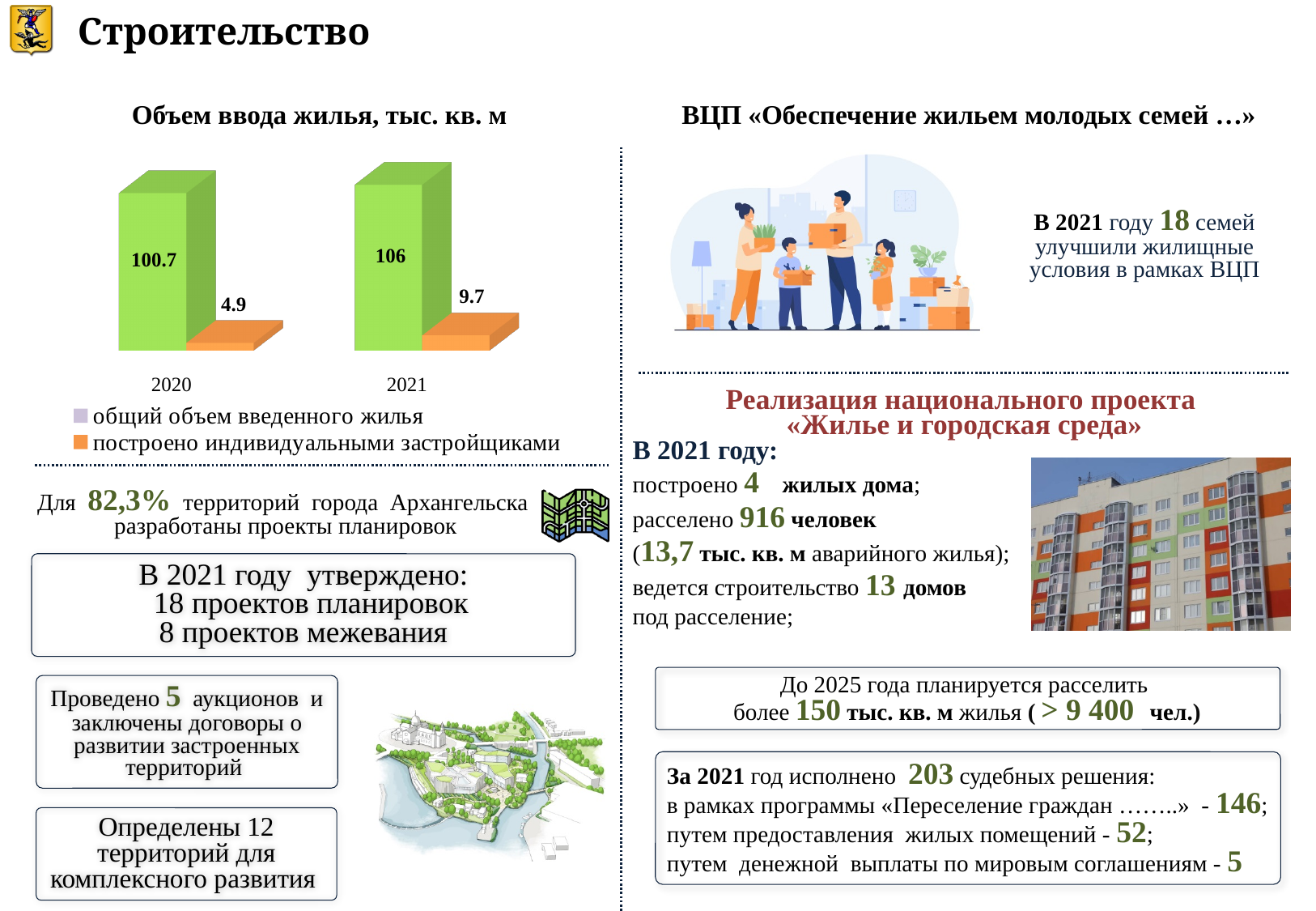
What is the difference between 'построено индивидуальными застройщиками' in 2021 and in 2020? 4.8 By how much did 'общий объем введенного жилья' change from 2020 to 2021? 5.3 What is the value for 'построено индивидуальными застройщиками' in 2020? 4.9 What type of chart is used to show 'Объем ввода жилья, тыс. кв. м'? Bar chart How many years (categories) are shown on the x axis of the chart? 2 In which year is 'построено индивидуальными застройщиками' lower? 2020 What is the value for 'общий объем введенного жилья' in 2020? 100.7 How many series does the chart legend list? 2 What is the value for 'общий объем введенного жилья' in 2021? 106 Which is larger: 'построено индивидуальными застройщиками' in 2020 or in 2021? 2021 What is the value for 'построено индивидуальными застройщиками' in 2021? 9.7 In which year is 'общий объем введенного жилья' higher? 2021